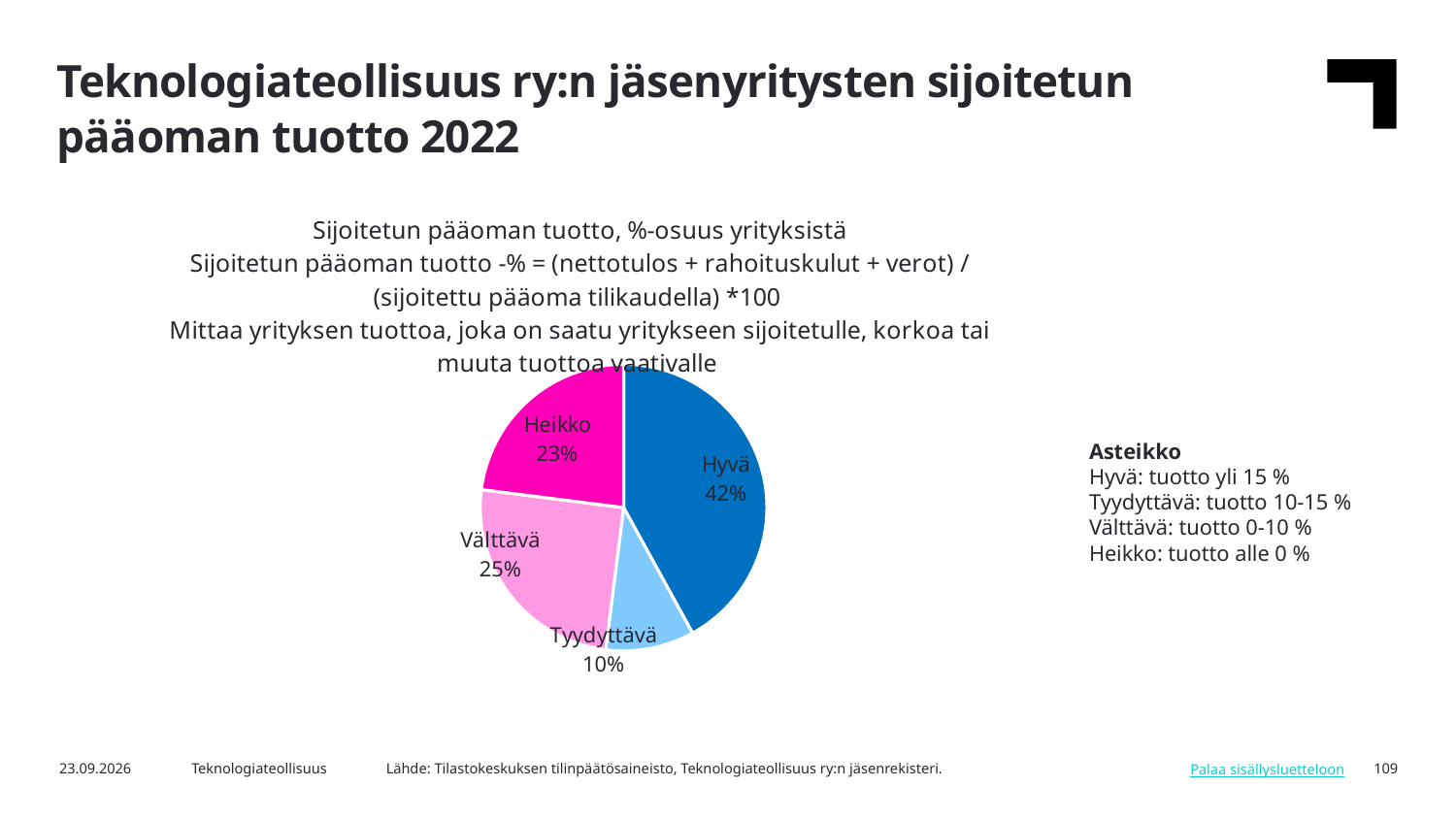
Which category has the largest share of the pie? Hyvä What share of companies falls in the Heikko category? 23% What kind of chart is shown on the slide? pie chart Which category has the smallest share of the pie? Tyydyttävä What share of companies falls in the Välttävä category? 25% What colour is the Hyvä slice of the pie? dark blue What share of companies falls in the Hyvä category? 42% What is the difference in percentage points between the Hyvä and Heikko shares? 19 What is the combined share of the Välttävä and Tyydyttävä categories? 35% What share of companies falls in the Tyydyttävä category? 10% How many categories does the pie chart have? 4 Which is larger, the Välttävä share or the Heikko share? Välttävä